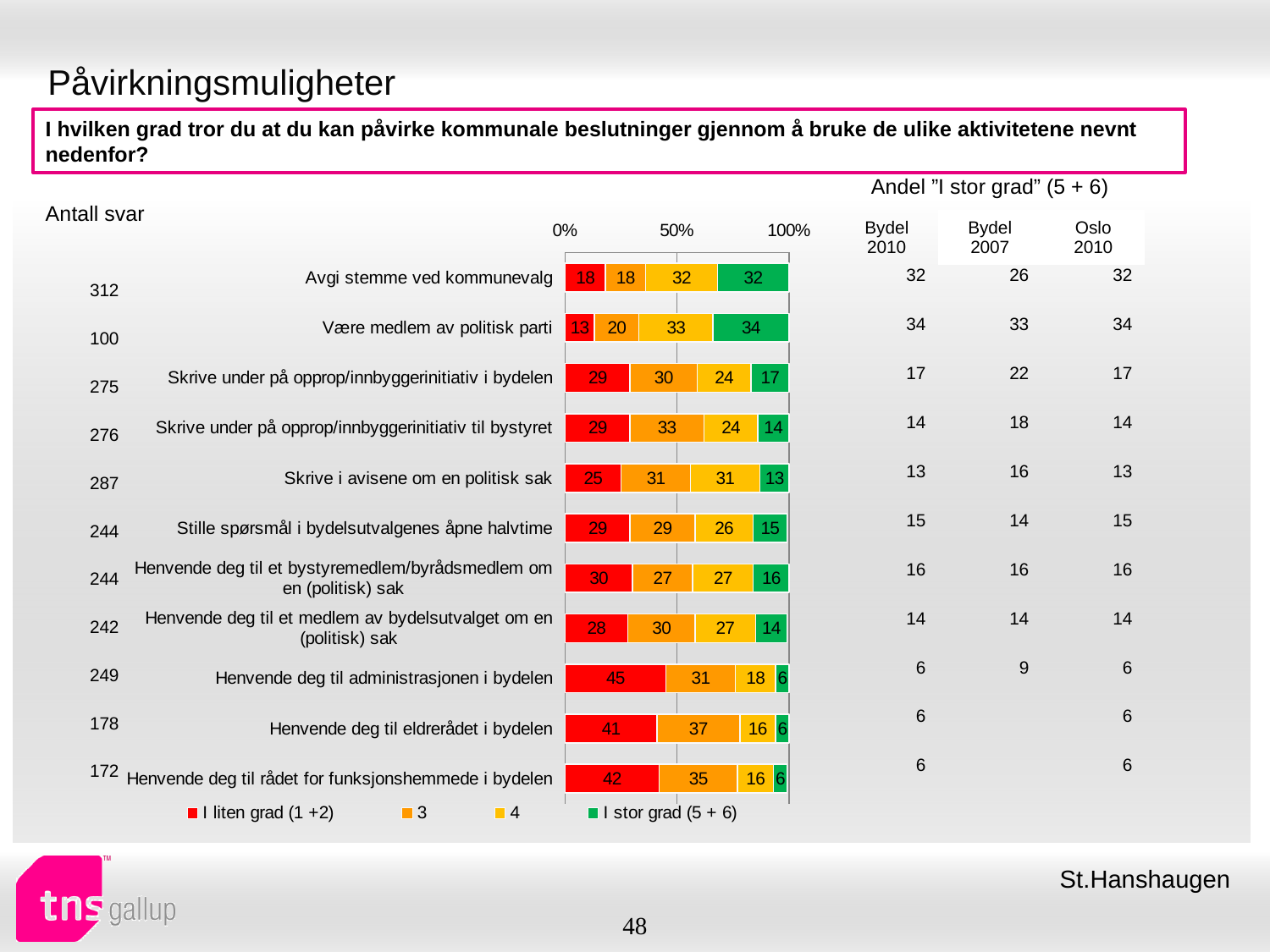
What is the value of "I liten grad (1 +2)" for "Henvende deg til administrasjonen i bydelen"? 45 How many series does the chart legend list? 4 What is the value of series "3" for "Skrive under på opprop/innbyggerinitiativ til bystyret"? 33 What is the difference between the "I liten grad (1 +2)" values for "Henvende deg til administrasjonen i bydelen" and "Henvende deg til eldrerådet i bydelen"? 4 How many categories (activities) are plotted in the chart? 11 Which category has the highest value for "I stor grad (5 + 6)"? Være medlem av politisk parti Which category has the lowest value for "I liten grad (1 +2)"? Være medlem av politisk parti What is the total of the stacked bar for "Avgi stemme ved kommunevalg"? 100 Which colour represents "I stor grad (5 + 6)" in the chart? Green What is the value of "I stor grad (5 + 6)" for "Avgi stemme ved kommunevalg"? 32 What kind of chart is shown on the slide? Stacked bar chart Which is larger: the "I stor grad (5 + 6)" value for "Skrive under på opprop/innbyggerinitiativ i bydelen" or for "Skrive i avisene om en politisk sak"? Skrive under på opprop/innbyggerinitiativ i bydelen